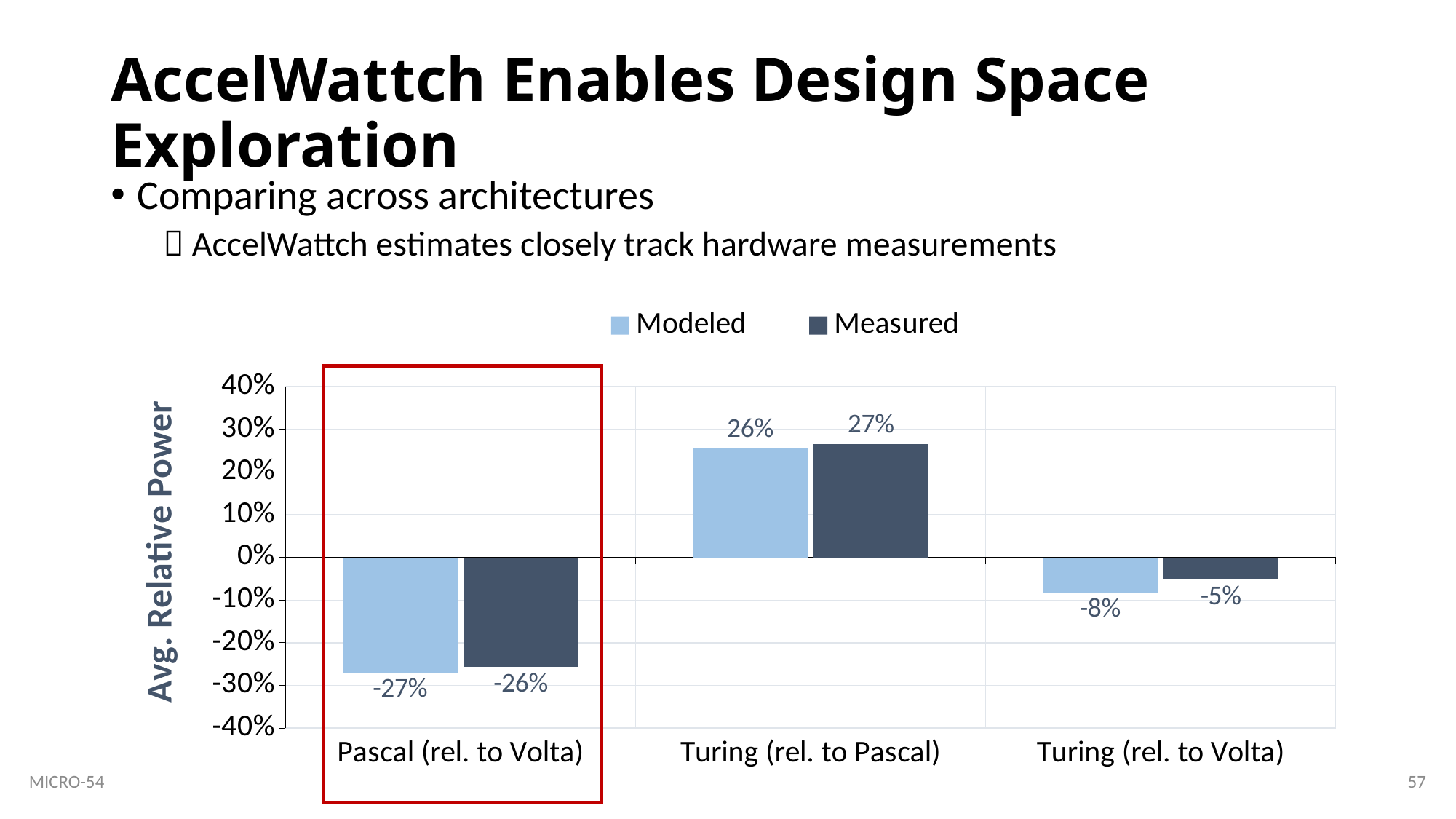
How many categories are shown on the x axis? 3 What is the Measured value for Turing (rel. to Pascal)? 27% What is the Modeled value for Turing (rel. to Volta)? -8% What is the Measured value for Turing (rel. to Volta)? -5% What kind of chart is shown on the slide? Bar chart What is the Measured value for Pascal (rel. to Volta)? -26% Which category has the lowest Modeled value? Pascal (rel. to Volta) What is the difference between the Measured and Modeled values for Turing (rel. to Volta)? 3% What is the Modeled value for Pascal (rel. to Volta)? -27% How many series does the legend list? 2 Which category has the highest Measured value? Turing (rel. to Pascal) What is the Modeled value for Turing (rel. to Pascal)? 26%